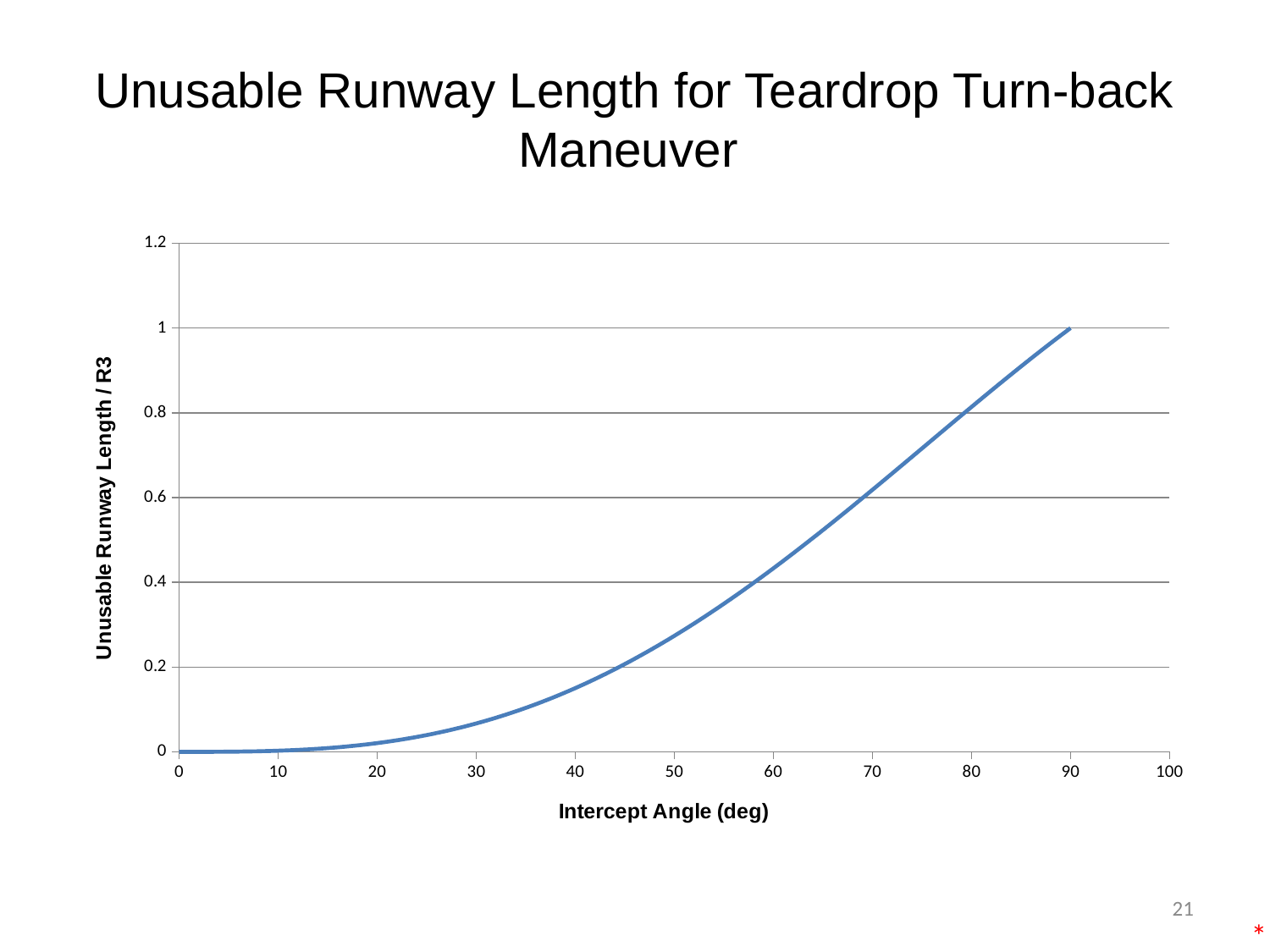
Is the value of Unusable Runway Length / R3 at an intercept angle of 30 degrees greater or less than 0.2? less What is the title of the chart on the slide? Unusable Runway Length for Teardrop Turn-back Maneuver At which intercept angle is the Unusable Runway Length / R3 highest? 90 Is the value of Unusable Runway Length / R3 at an intercept angle of 50 degrees greater or less than 0.4? less What is the label of the x axis? Intercept Angle (deg) Is the value of Unusable Runway Length / R3 at an intercept angle of 70 degrees greater or less than 0.4? greater What is the value of Unusable Runway Length / R3 at an intercept angle of 0 degrees? 0 What kind of chart is shown on the slide? Line chart What is the value of Unusable Runway Length / R3 at an intercept angle of 90 degrees? 1 Does the Unusable Runway Length / R3 rise or fall as the intercept angle increases? Rises At which intercept angle is the Unusable Runway Length / R3 lowest? 0